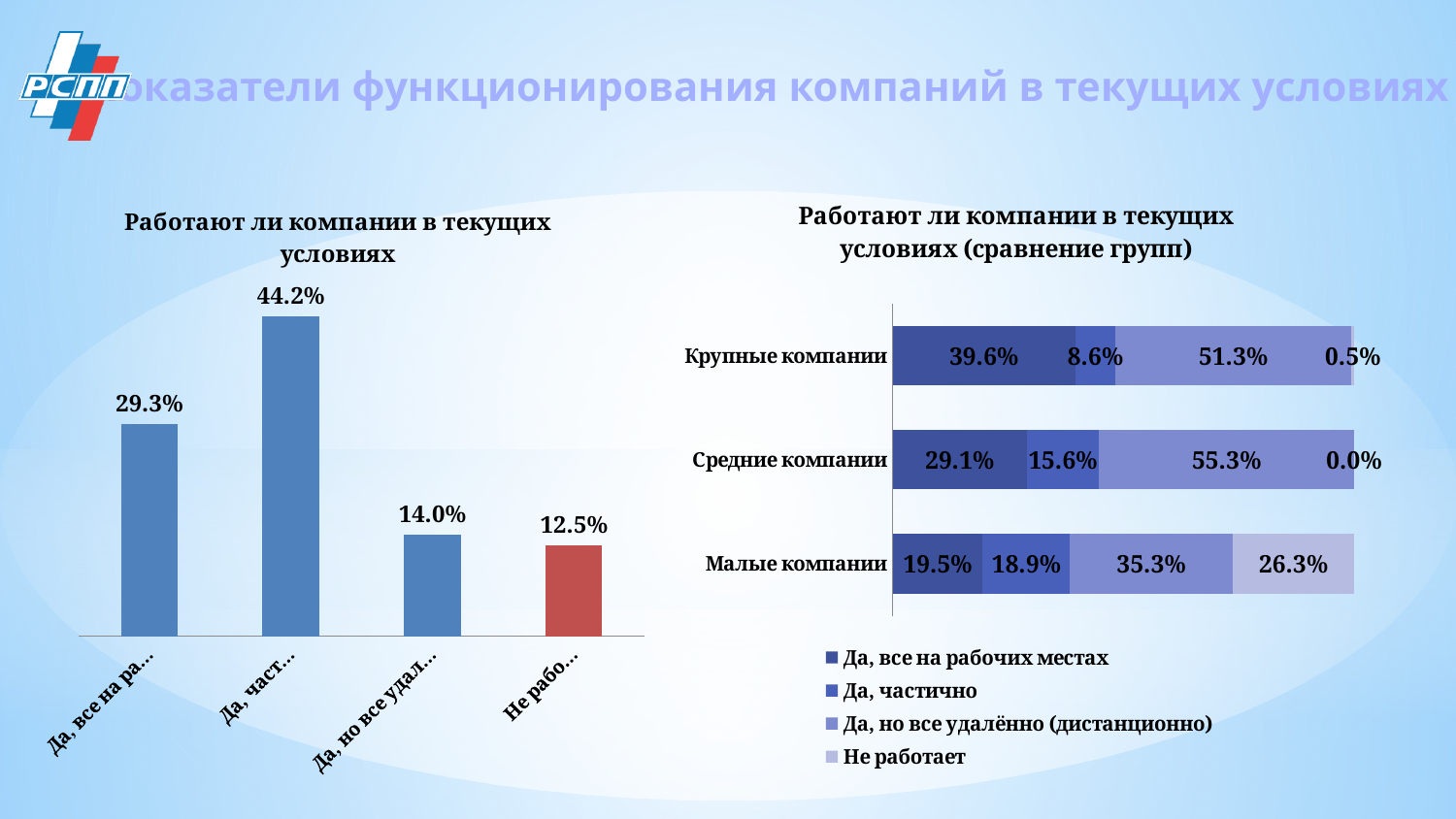
In the right chart 'Работают ли компании в текущих условиях (сравнение групп)', what is the difference between 'Да, все на рабочих местах' for Крупные компании and for Малые компании? 20.1% In the left chart 'Работают ли компании в текущих условиях', what is the value of the red bar (labelled 'Не рабо...')? 12.5% In the left chart 'Работают ли компании в текущих условиях', what is the difference between the first bar (29.3%) and the third bar (14.0%)? 15.3% In the left chart 'Работают ли компании в текущих условиях', how many bars are plotted? 4 In the left chart 'Работают ли компании в текущих условиях', what is the value of the second bar (labelled 'Да, част...')? 44.2% In the right chart 'Работают ли компании в текущих условиях (сравнение групп)', what is the value of 'Да, все на рабочих местах' for Крупные компании? 39.6% How many series does the legend of the right chart 'Работают ли компании в текущих условиях (сравнение групп)' list? 4 In the right chart 'Работают ли компании в текущих условиях (сравнение групп)', which company group has the highest value for 'Да, но все удалённо (дистанционно)'? Средние компании What type of chart is the left chart 'Работают ли компании в текущих условиях'? Bar chart In the left chart 'Работают ли компании в текущих условиях', which bar is the highest? Да, част... (the second bar) In the right chart 'Работают ли компании в текущих условиях (сравнение групп)', which is larger: 'Да, частично' for Средние компании or for Крупные компании? Средние компании In the right chart 'Работают ли компании в текущих условиях (сравнение групп)', what is the value of 'Не работает' for Малые компании? 26.3%